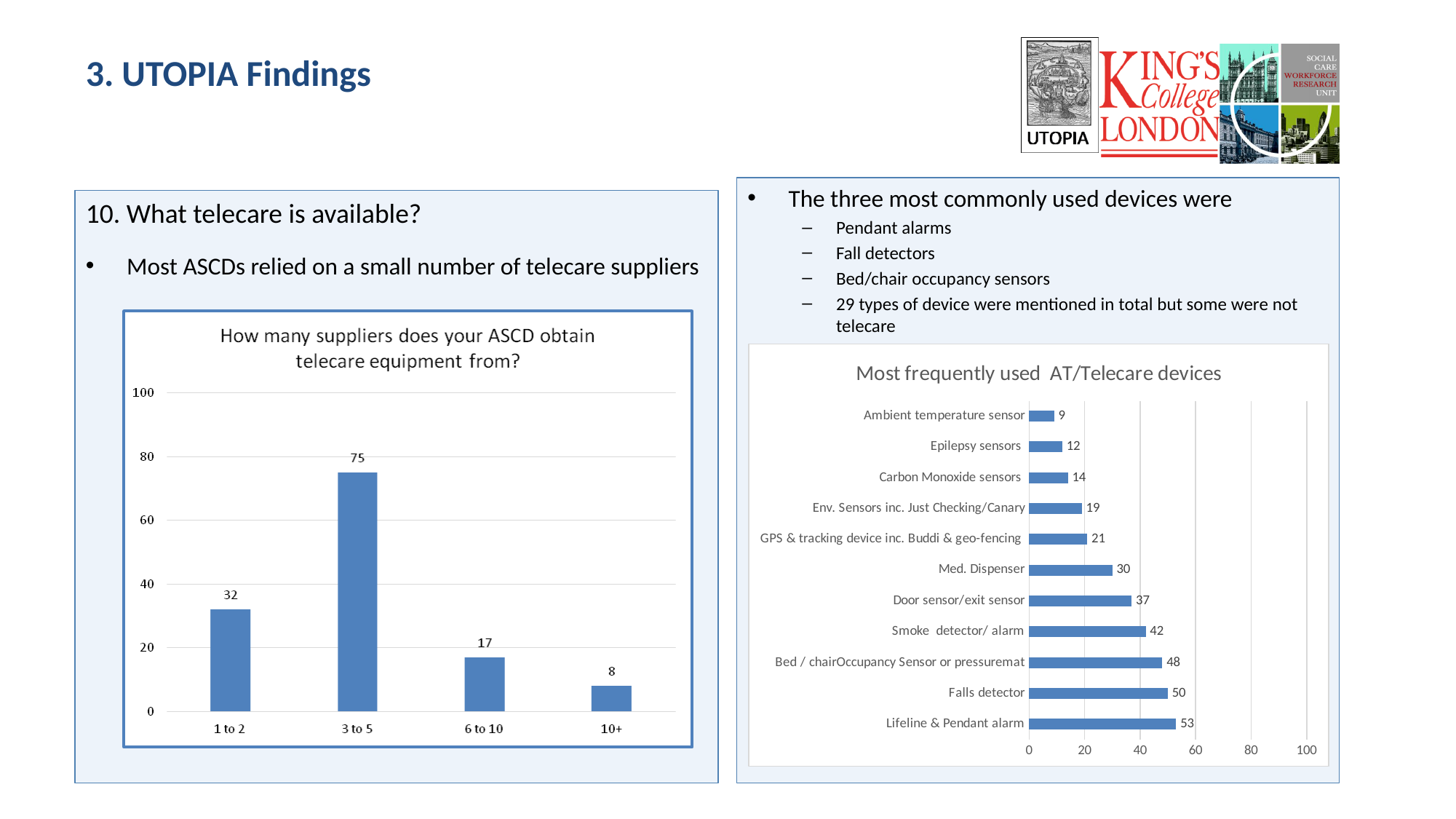
In the chart titled 'Most frequently used AT/Telecare devices', which device has the lowest value? Ambient temperature sensor In the chart titled 'Most frequently used AT/Telecare devices', what is the difference between the values for 'Falls detector' and 'Smoke detector/ alarm'? 8 In the chart titled 'How many suppliers does your ASCD obtain telecare equipment from?', what is the value for '3 to 5'? 75 In the chart titled 'How many suppliers does your ASCD obtain telecare equipment from?', what kind of chart is it? Bar chart In the chart titled 'Most frequently used AT/Telecare devices', how many devices are listed? 11 In the chart titled 'How many suppliers does your ASCD obtain telecare equipment from?', what is the difference between the values for '1 to 2' and '6 to 10'? 15 In the chart titled 'Most frequently used AT/Telecare devices', which is larger: the value for 'Door sensor/exit sensor' or the value for 'GPS & tracking device inc. Buddi & geo-fencing'? Door sensor/exit sensor In the chart titled 'Most frequently used AT/Telecare devices', what is the value for 'Carbon Monoxide sensors'? 14 In the chart titled 'How many suppliers does your ASCD obtain telecare equipment from?', how many categories are shown on the x axis? 4 In the chart titled 'How many suppliers does your ASCD obtain telecare equipment from?', which category has the lowest value? 10+ In the chart titled 'Most frequently used AT/Telecare devices', what is the value for 'Med. Dispenser'? 30 In the chart titled 'Most frequently used AT/Telecare devices', which device has the highest value? Lifeline & Pendant alarm